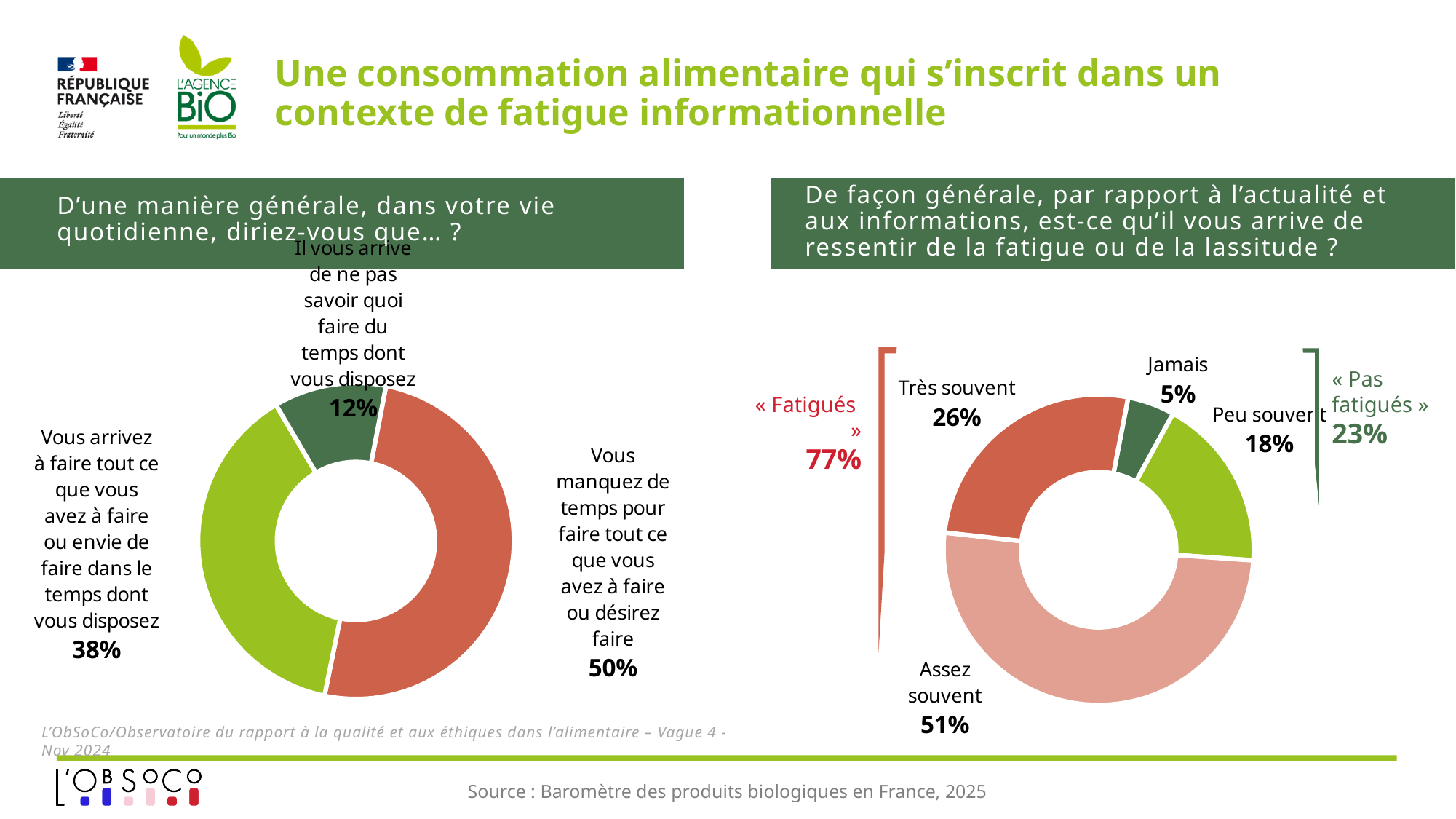
In the right chart, what is the combined share labelled "Fatigués"? 77% In the right chart, is the share for "Peu souvent" larger or smaller than the share for "Très souvent"? smaller In the left chart, what share of respondents say they sometimes do not know what to do with their time ("Il vous arrive de ne pas savoir quoi faire...")? 12% What type of chart is used on the right side of the slide? Donut (pie) chart In the left chart, which category has the smallest share? Il vous arrive de ne pas savoir quoi faire du temps dont vous disposez In the right chart, which category has the largest share? Assez souvent In the left chart, what share of respondents say they manage to do everything they have to do or want to do ("Vous arrivez à faire tout ce que vous avez à faire...")? 38% In the right chart, what share of respondents answered "Très souvent"? 26% In the right chart, what share of respondents answered "Assez souvent"? 51% In the left chart, what is the difference between the share who lack time (50%) and the share who manage to do everything (38%)? 12 percentage points In the left chart, what share of respondents say they lack time to do everything they have to do or want to do ("Vous manquez de temps...")? 50% In the right chart, what share of respondents answered "Jamais"? 5%